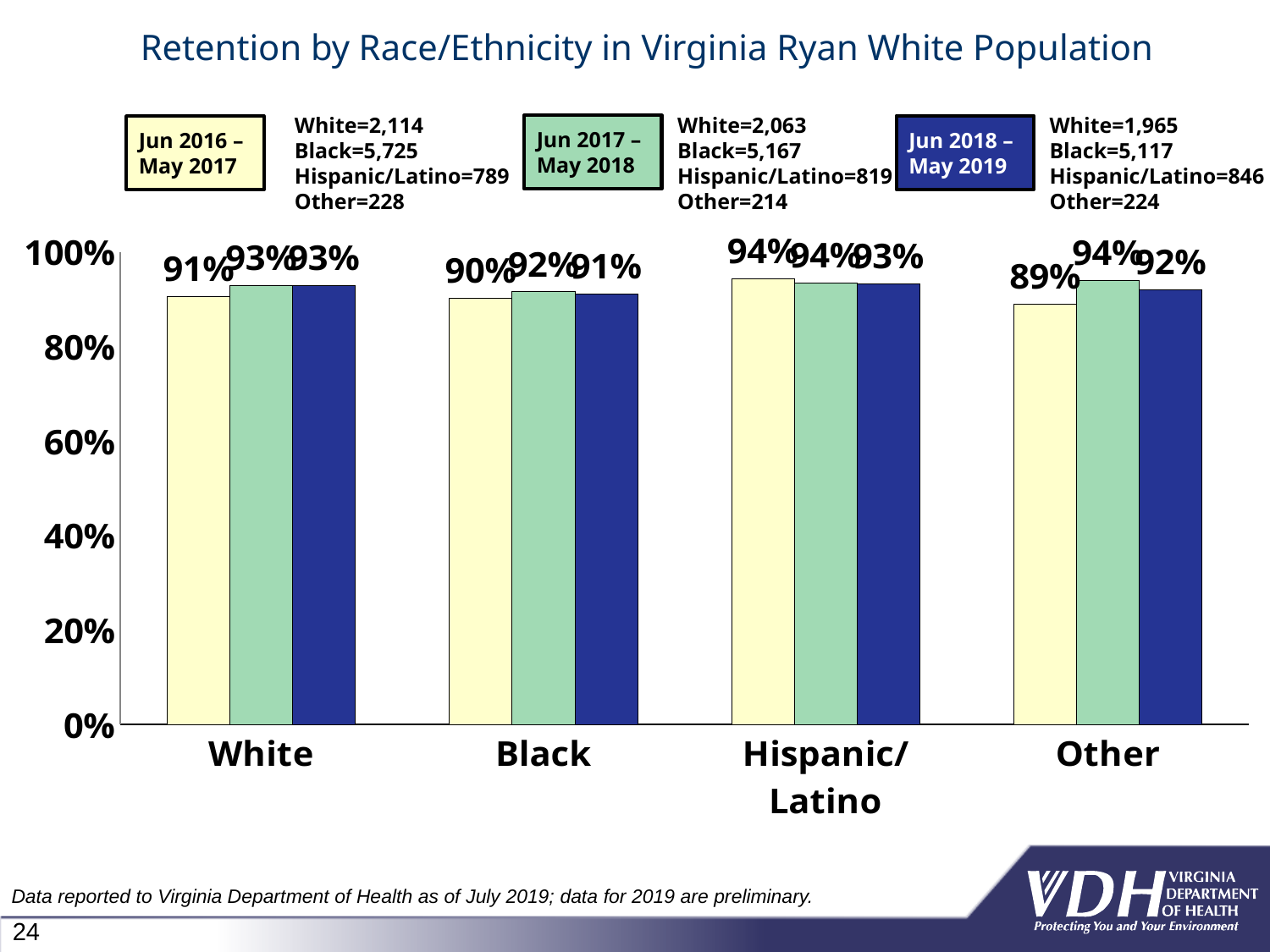
How many time periods (series) does the legend list? 3 How many race/ethnicity categories are shown on the x axis? 4 Which race/ethnicity category has the lowest retention value in the Jun 2016 – May 2017 period? Other What is the retention value for White in the Jun 2016 – May 2017 period? 91% Which is larger for Black: the Jun 2017 – May 2018 value or the Jun 2016 – May 2017 value? Jun 2017 – May 2018 What is the retention value for Hispanic/Latino in the Jun 2016 – May 2017 period? 94% Which race/ethnicity category has the highest retention value in the Jun 2016 – May 2017 period? Hispanic/Latino What kind of chart is shown on the slide? Bar chart What is the retention value for Black in the Jun 2017 – May 2018 period? 92% What is the retention value for Other in the Jun 2018 – May 2019 period? 92% Is the retention value for Other in the Jun 2016 – May 2017 period greater or less than 80%? greater What is the difference between the Jun 2018 – May 2019 and Jun 2016 – May 2017 retention values for Other? 3%